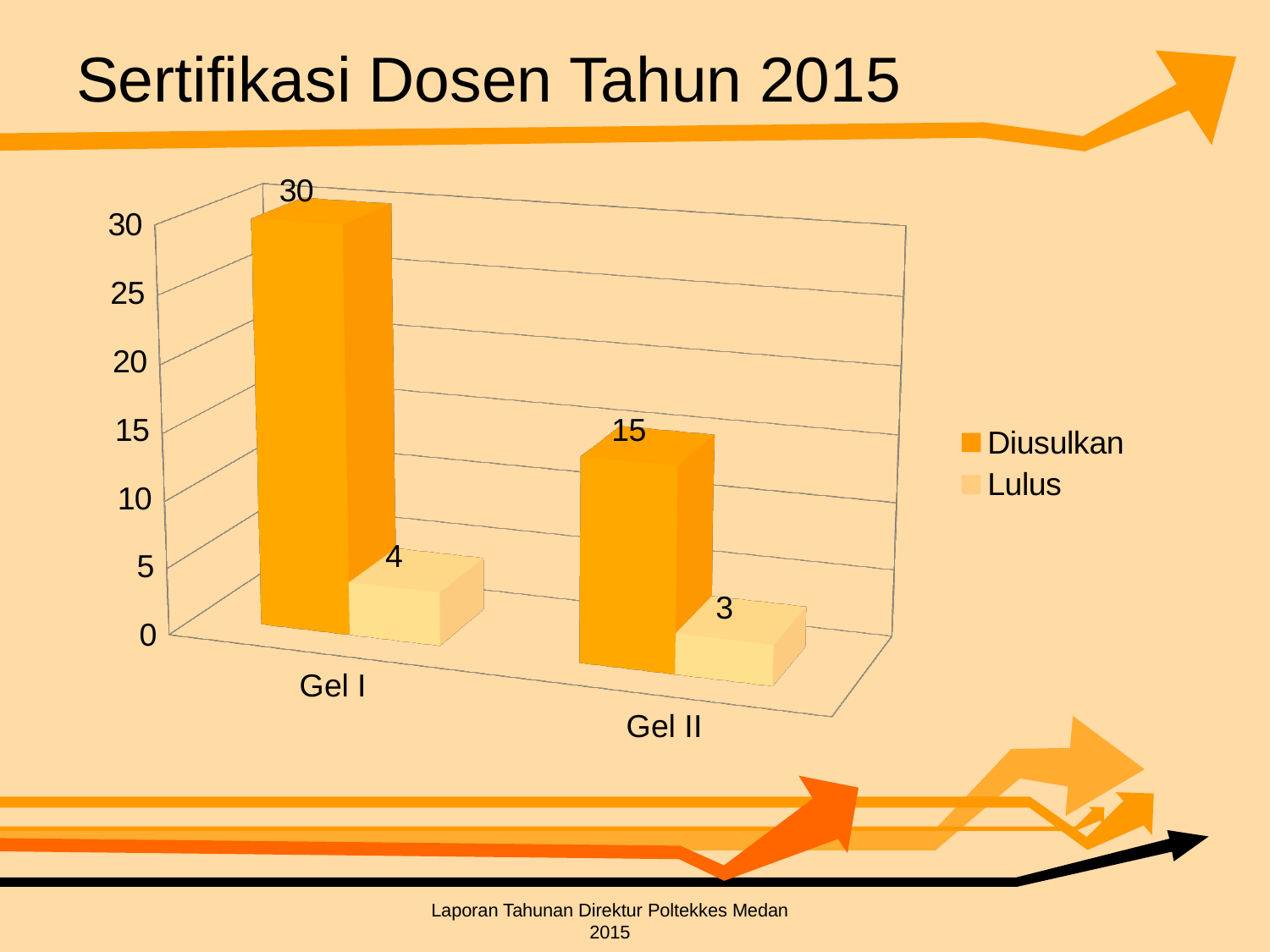
How many series does the legend list? 2 Which category has the lowest Lulus value? Gel II What is the Diusulkan value for Gel I? 30 What is the title of the slide? Sertifikasi Dosen Tahun 2015 What is the Diusulkan value for Gel II? 15 What is the Lulus value for Gel II? 3 Which is larger: the Lulus value for Gel I or the Lulus value for Gel II? Gel I Which category has the highest Diusulkan value? Gel I What is the Lulus value for Gel I? 4 What kind of chart is shown on the slide? Bar chart What is the difference between the Diusulkan values for Gel I and Gel II? 15 How many categories are shown on the x axis? 2